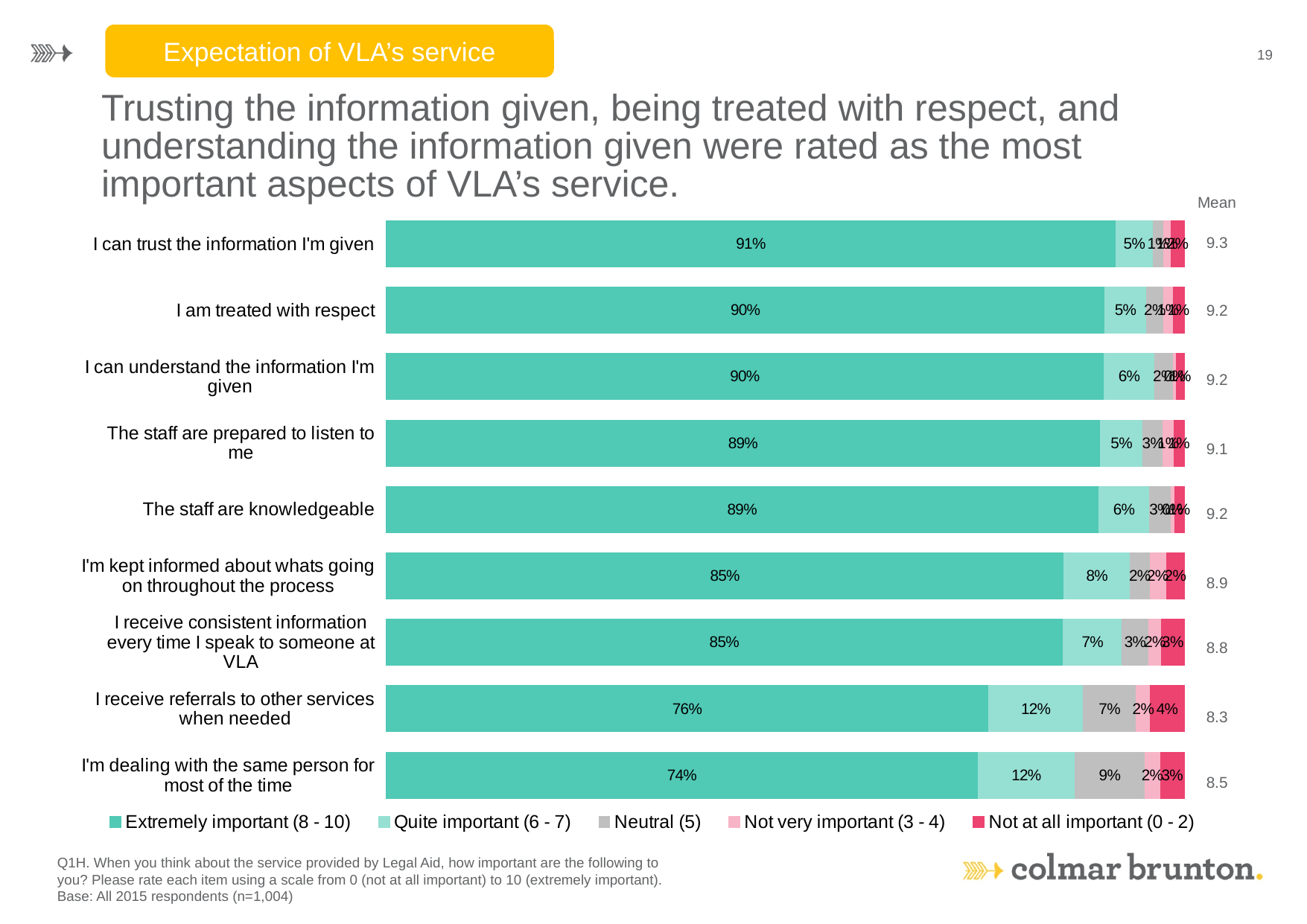
What percentage rated 'I'm dealing with the same person for most of the time' as Extremely important (8 - 10)? 74% Which has a larger Extremely important percentage: 'The staff are knowledgeable' or 'I'm kept informed about whats going on throughout the process'? The staff are knowledgeable How many series does the legend list? 5 What is the Neutral (5) percentage for 'I'm dealing with the same person for most of the time'? 9% What kind of chart is shown on the slide? Stacked bar chart Which aspect has the lowest Extremely important (8 - 10) percentage? I'm dealing with the same person for most of the time What is the mean score shown for 'I receive referrals to other services when needed'? 8.3 What is the difference between the Extremely important percentages for 'I can trust the information I'm given' and 'I receive referrals to other services when needed'? 15% How many service aspects (categories) are plotted in the chart? 9 What percentage rated 'I can trust the information I'm given' as Extremely important (8 - 10)? 91% What is the Quite important (6 - 7) percentage for 'I receive referrals to other services when needed'? 12% Which aspect has the highest Extremely important (8 - 10) percentage? I can trust the information I'm given